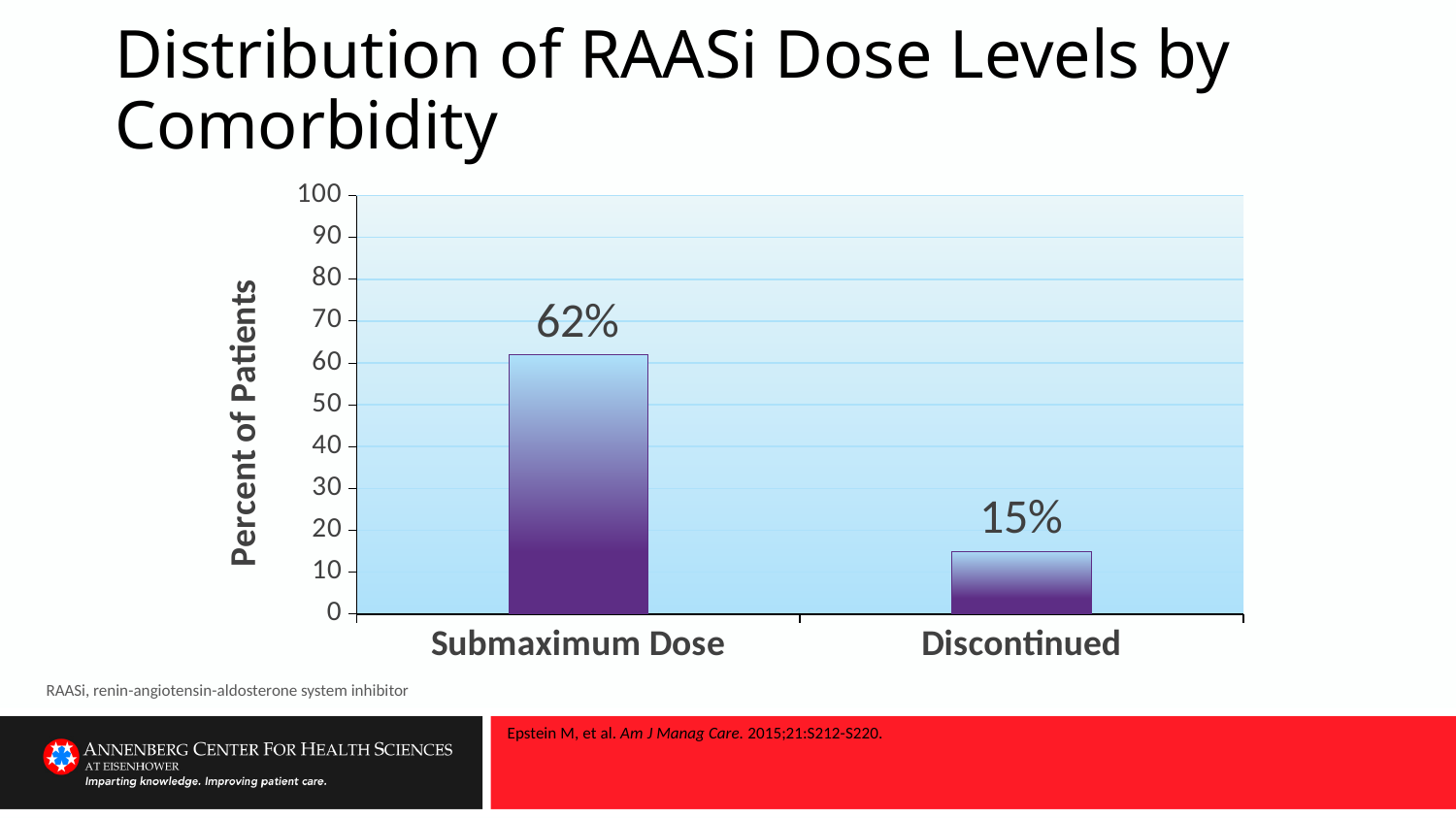
Is the value for Submaximum Dose greater or less than 50? greater What percent of patients Discontinued? 15% What is the difference in percent of patients between Submaximum Dose and Discontinued? 47% What percent of patients are on a Submaximum Dose? 62% Which category has the higher percent of patients? Submaximum Dose Which category has the lower percent of patients? Discontinued Is the value for Discontinued greater or less than 20? less Is the value for Submaximum Dose larger or smaller than the value for Discontinued? larger What is the maximum value shown on the y axis? 100 How many categories are shown on the x axis? 2 What kind of chart is shown on the slide? bar chart What is the label of the y axis? Percent of Patients